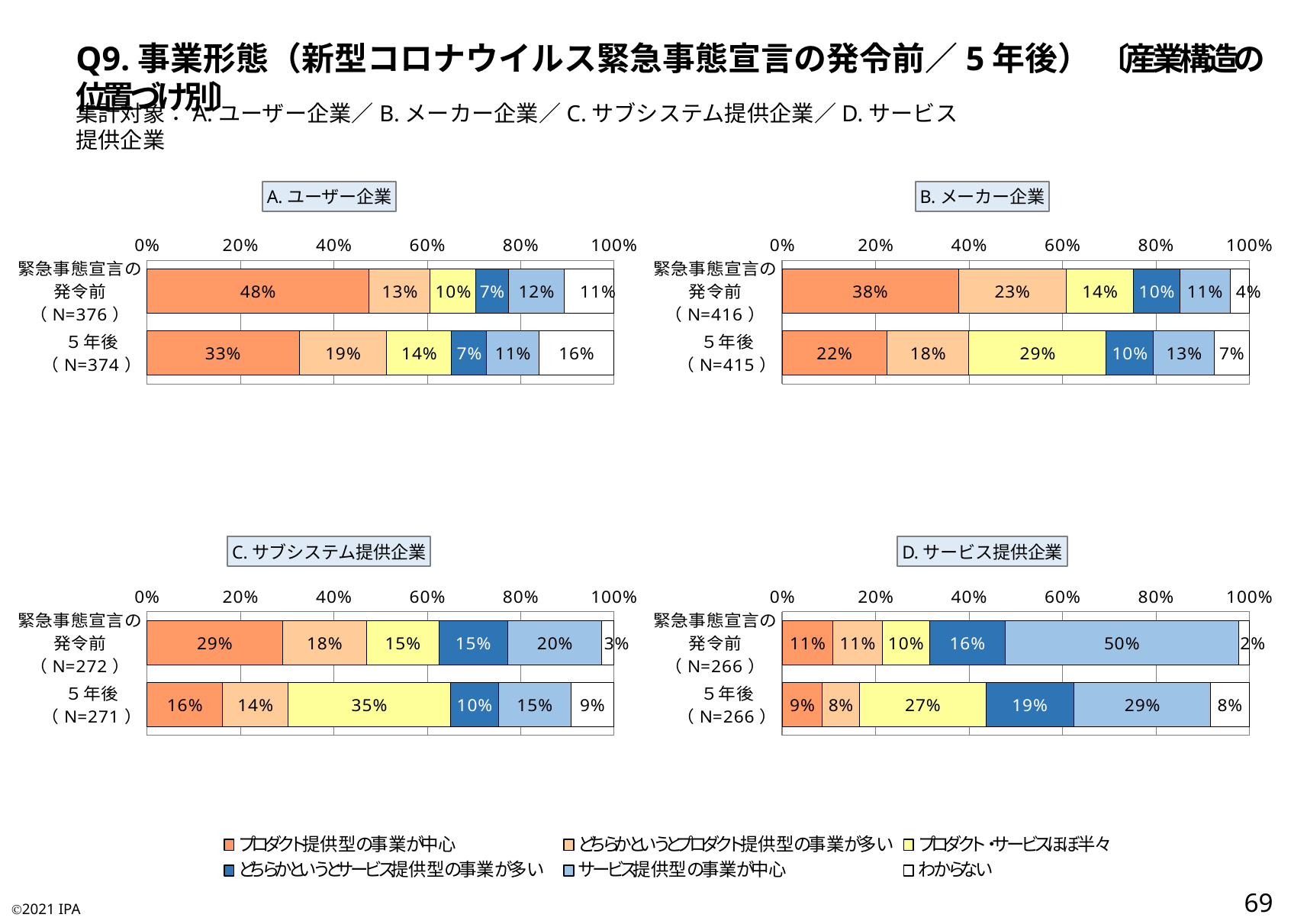
In the C. サブシステム提供企業 chart, which segment is the largest in the 5年後 bar? プロダクト・サービスほぼ半々 How many bars does the A. ユーザー企業 chart have? 2 In the A. ユーザー企業 chart, what is the difference between プロダクト提供型の事業が中心 for 緊急事態宣言の発令前 and for 5年後? 15% In the B. メーカー企業 chart, which segment is the smallest in the 緊急事態宣言の発令前 bar? わからない What kind of chart is the D. サービス提供企業 chart? Stacked bar chart In the B. メーカー企業 chart, what is the value of プロダクト・サービスほぼ半々 for 5年後? 29% How many series does the legend list? 6 What is the N for the 5年後 bar in the B. メーカー企業 chart? N=415 In the D. サービス提供企業 chart, which is larger for 5年後: プロダクト・サービスほぼ半々 or サービス提供型の事業が中心? サービス提供型の事業が中心 In the C. サブシステム提供企業 chart, what is the value of わからない for 5年後? 9% In the A. ユーザー企業 chart, what is the value of プロダクト提供型の事業が中心 for 緊急事態宣言の発令前? 48% In the D. サービス提供企業 chart, what is the value of サービス提供型の事業が中心 for 緊急事態宣言の発令前? 50%